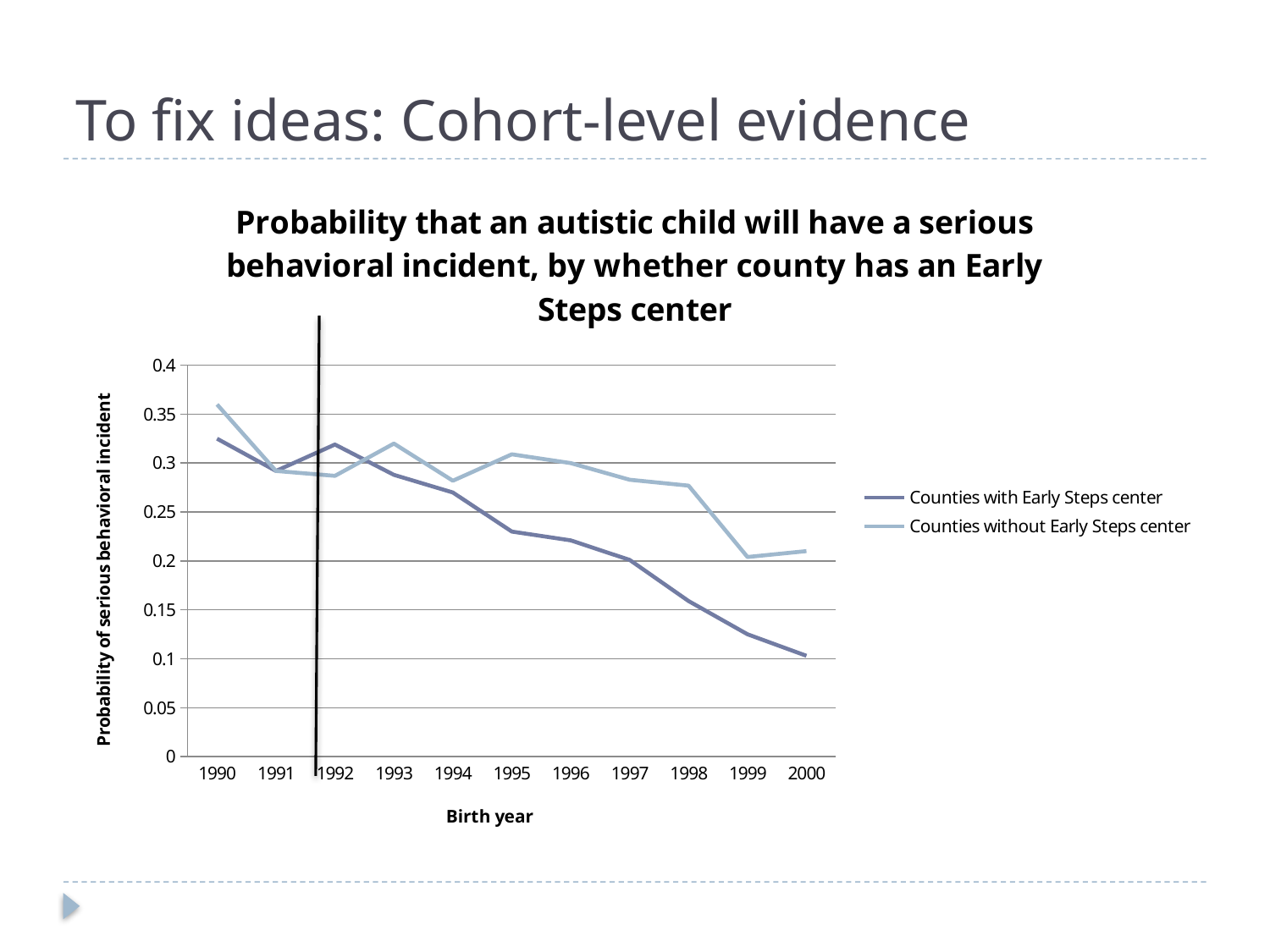
For the 'Counties without Early Steps center' series, which birth year has the highest value? 1990 What kind of chart is shown on the slide? Line chart What is the title of the x axis? Birth year Is the value for 'Counties with Early Steps center' in 1995 greater or less than 0.25? less How many series does the legend list? 2 Which series has the higher value for birth year 2000? Counties without Early Steps center How many birth years are plotted along the x axis? 11 Is the value for 'Counties with Early Steps center' in 2000 greater or less than 0.15? less Is the value for 'Counties without Early Steps center' in 1996 greater or less than 0.25? greater Which series has the higher value for birth year 1992? Counties with Early Steps center For the 'Counties with Early Steps center' series, which birth year has the lowest value? 2000 Does the 'Counties with Early Steps center' series generally rise or fall from 1992 to 2000? fall